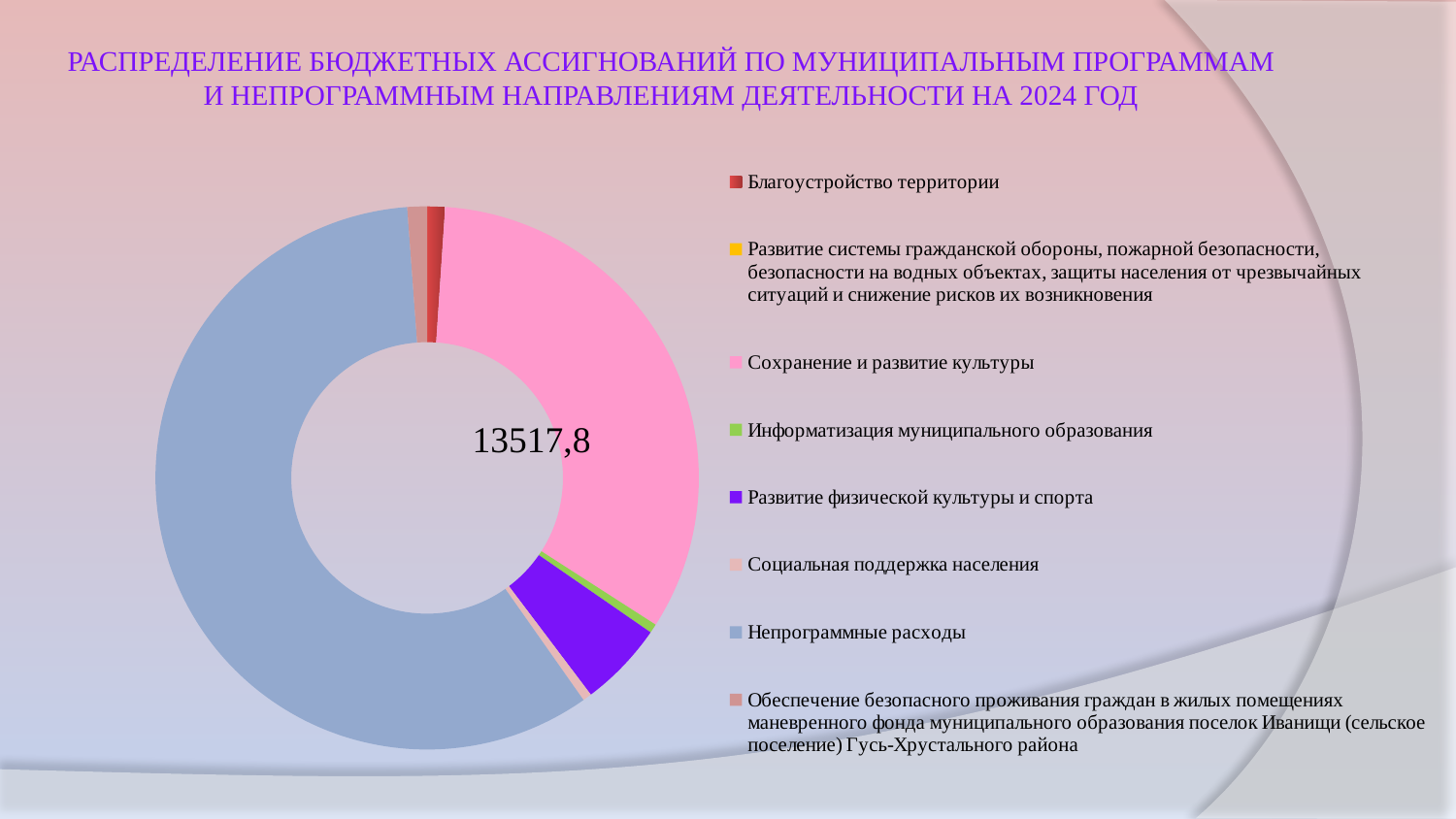
Which category has the largest slice in the chart? Непрограммные расходы Which category is shown in pink in the chart? Сохранение и развитие культуры Which slice is larger: Непрограммные расходы or Сохранение и развитие культуры? Непрограммные расходы Which slice is larger: Развитие физической культуры и спорта or Информатизация муниципального образования? Развитие физической культуры и спорта Which slice is larger: Сохранение и развитие культуры or Развитие физической культуры и спорта? Сохранение и развитие культуры How many categories does the chart's legend list? 8 What number is printed in the centre of the doughnut chart? 13517,8 What kind of chart is shown on the slide? doughnut (pie) chart